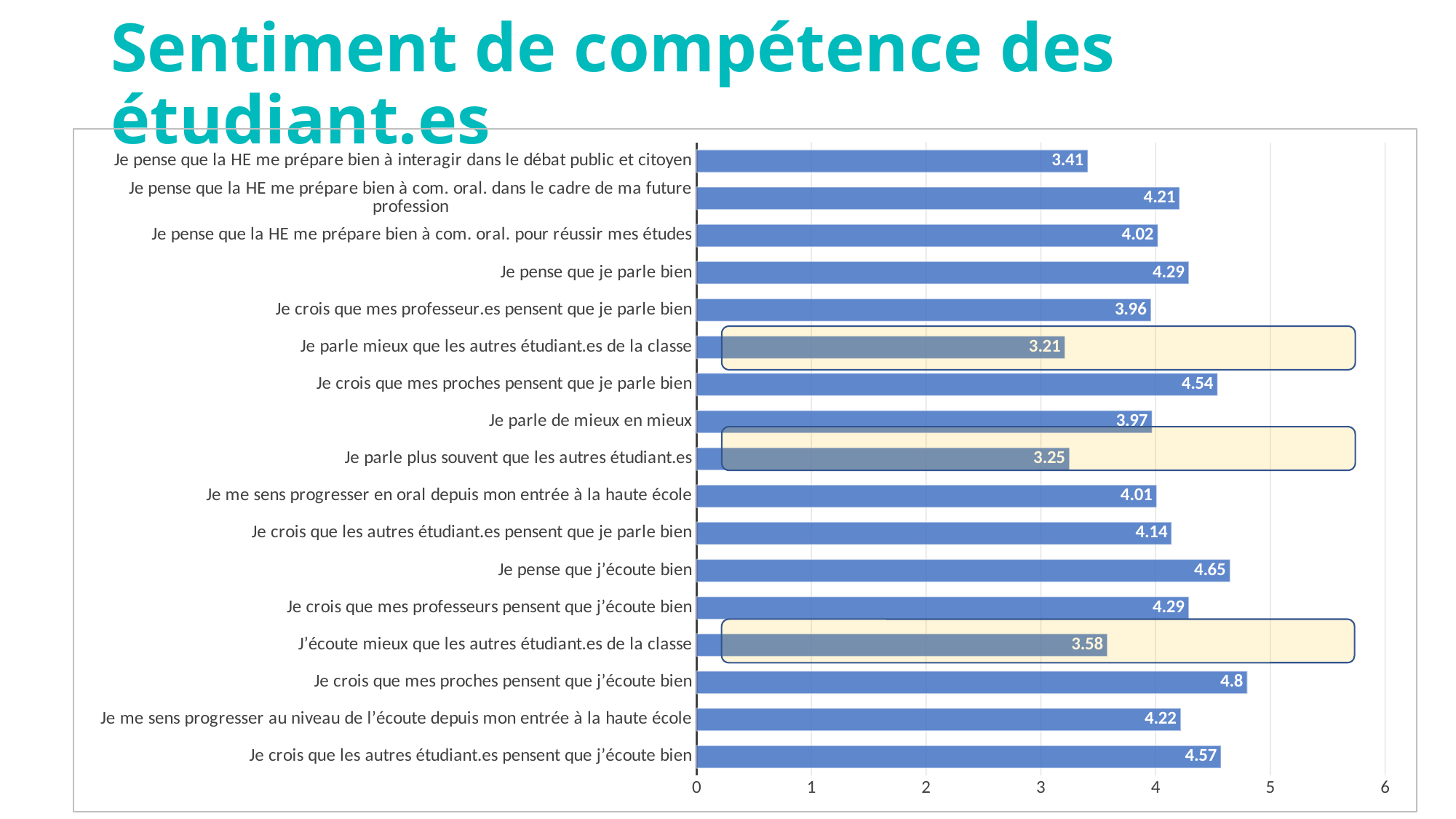
What is the value for "Je pense que j’écoute bien"? 4.65 Which category has the lowest value? Je parle mieux que les autres étudiant.es de la classe What is the value for "Je parle mieux que les autres étudiant.es de la classe"? 3.21 What kind of chart is shown on the slide? bar chart What is the difference between the values for "Je crois que mes proches pensent que j’écoute bien" and "Je parle mieux que les autres étudiant.es de la classe"? 1.59 Which category has the highest value? Je crois que mes proches pensent que j’écoute bien Which is larger: the value for "Je pense que je parle bien" or the value for "Je crois que mes proches pensent que je parle bien"? Je crois que mes proches pensent que je parle bien How many categories are shown in the chart? 17 What is the value for "Je crois que mes proches pensent que j’écoute bien"? 4.8 What is the value for "Je pense que la HE me prépare bien à interagir dans le débat public et citoyen"? 3.41 What is the difference between the values for "J’écoute mieux que les autres étudiant.es de la classe" and "Je parle plus souvent que les autres étudiant.es"? 0.33 Is the value for "Je crois que les autres étudiant.es pensent que j’écoute bien" greater or less than 4? greater